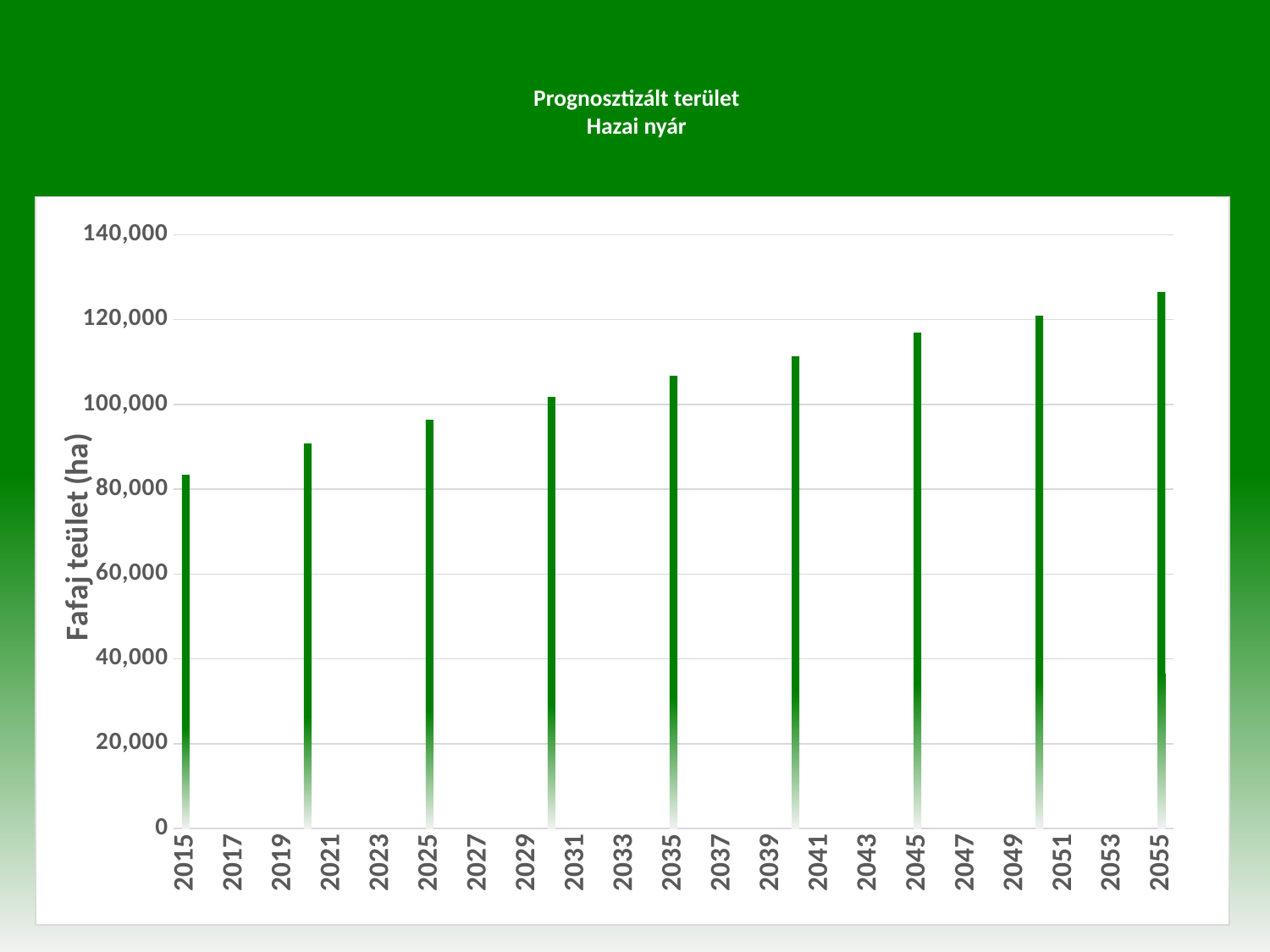
Which is larger, the value for 2015 or the value for 2045? 2045 What is the title of the chart? Prognosztizált terület Hazai nyár Is the value for 2035 greater or less than 100,000? greater Do the values rise or fall from 2015 to 2055? rise How many bars are plotted in the chart? 9 What is the label of the vertical axis? Fafaj teület (ha) Which year has the lowest bar? 2015 Is the value for 2055 greater or less than 120,000? greater What kind of chart is shown on the slide? bar chart Is the value for 2025 greater or less than 100,000? less Which year has the highest bar? 2055